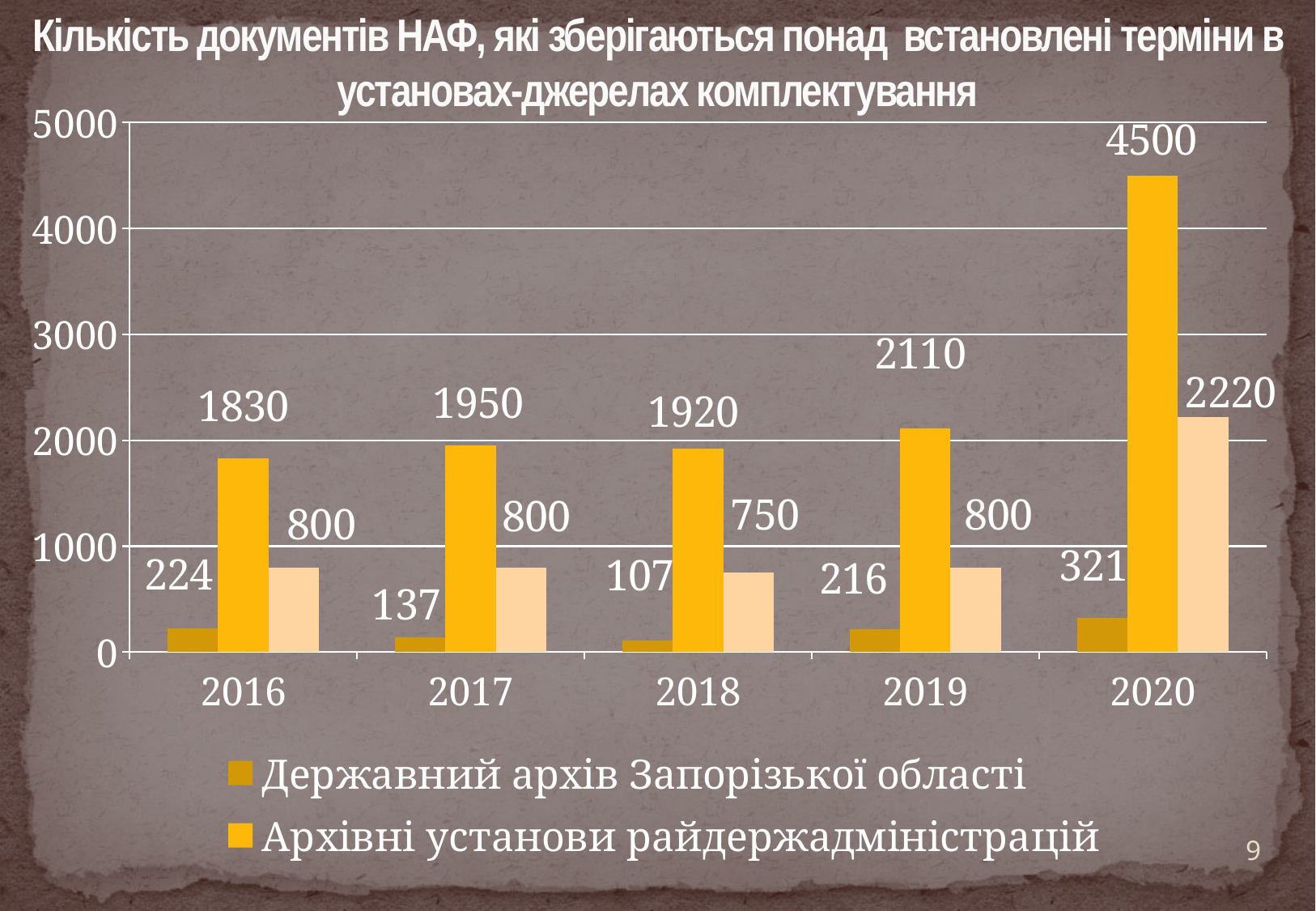
In which year is the value for Архівні установи райдержадміністрацій highest? 2020 In which year is the value for Державний архів Запорізької області lowest? 2018 What is the value for Державний архів Запорізької області in 2018? 107 Which is larger for Державний архів Запорізької області: the value in 2016 or in 2019? 2016 Is the value for Архівні установи райдержадміністрацій in 2019 greater or less than 2000? greater How many series does the legend list? 2 What is the value for Архівні установи райдержадміністрацій in 2020? 4500 What is the value for Архівні установи райдержадміністрацій in 2017? 1950 What is the difference between the values for Архівні установи райдержадміністрацій in 2020 and 2019? 2390 What kind of chart is shown on the slide? bar chart Does the value for Державний архів Запорізької області rise or fall from 2018 to 2020? rise How many years are shown on the x axis? 5